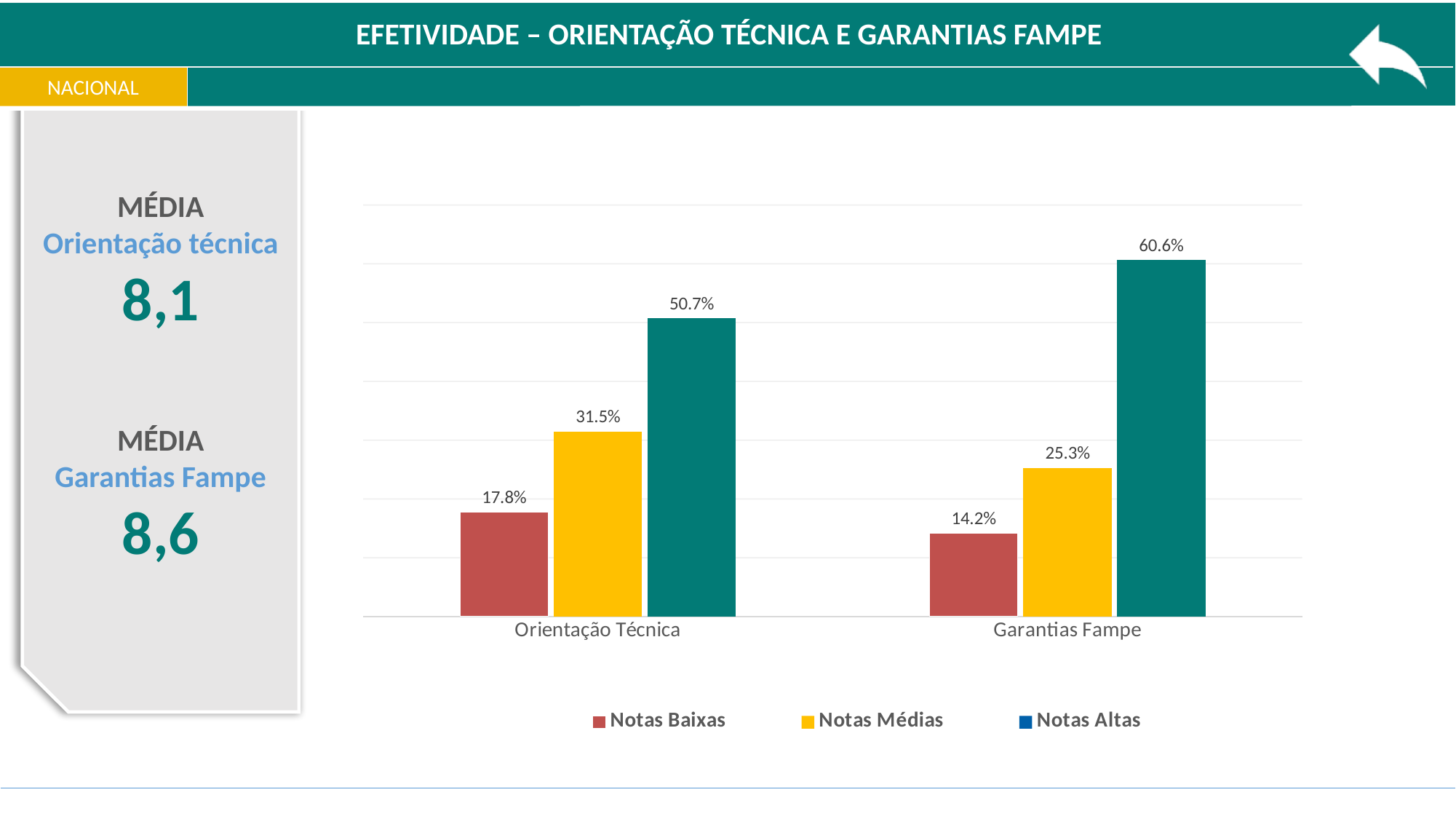
How many categories are shown on the x axis? 2 What kind of chart is shown on the slide? Bar chart Which series has the lowest value in the Orientação Técnica category? Notas Baixas Which is larger: Notas Médias for Orientação Técnica or Notas Médias for Garantias Fampe? Orientação Técnica What is the value for Notas Baixas in the Garantias Fampe category? 14.2% What is the difference between the Notas Altas values for Garantias Fampe and Orientação Técnica? 9.9% Which series has the highest value in the Garantias Fampe category? Notas Altas What is the value for Notas Médias in the Orientação Técnica category? 31.5% How many series does the legend list? 3 What colour are the Notas Médias bars? Yellow What is the value for Notas Altas in the Garantias Fampe category? 60.6% What is the value for Notas Altas in the Orientação Técnica category? 50.7%